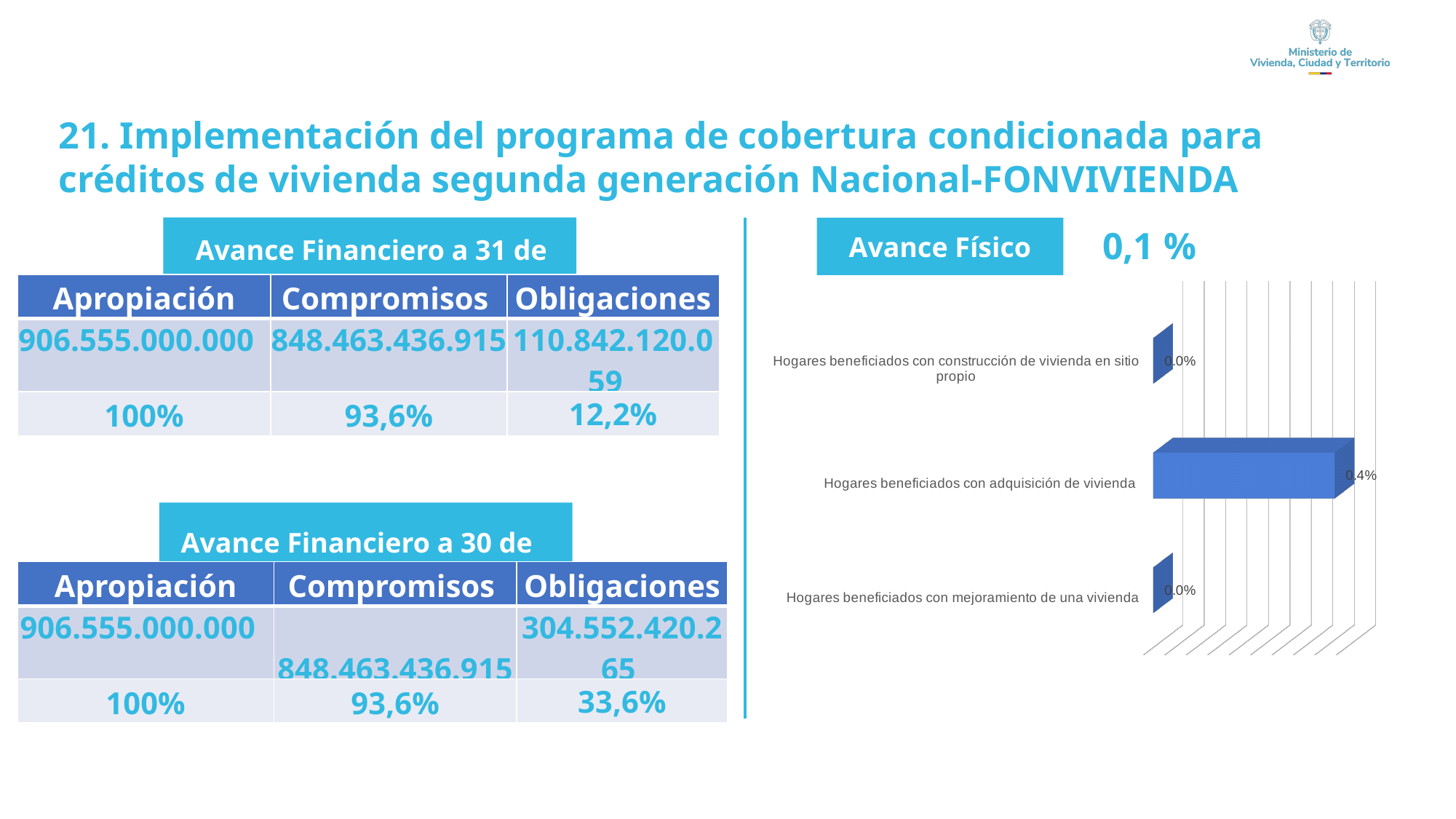
What kind of chart is shown on the right side of the slide? Bar chart How many categories in the bar chart have a value of 0.0%? 2 What is the value for 'Hogares beneficiados con adquisición de vivienda' in the bar chart? 0.4% What is the value for 'Hogares beneficiados con construcción de vivienda en sitio propio' in the bar chart? 0.0% What is the value for 'Hogares beneficiados con mejoramiento de una vivienda' in the bar chart? 0.0% What heading appears above the bar chart? Avance Físico Which category has the highest value in the bar chart? Hogares beneficiados con adquisición de vivienda What colour are the bars in the chart? Blue How many categories are shown in the bar chart? 3 Which is larger: the value for 'Hogares beneficiados con adquisición de vivienda' or the value for 'Hogares beneficiados con construcción de vivienda en sitio propio'? Hogares beneficiados con adquisición de vivienda What is the difference between the value for 'Hogares beneficiados con adquisición de vivienda' and the value for 'Hogares beneficiados con mejoramiento de una vivienda'? 0.4%